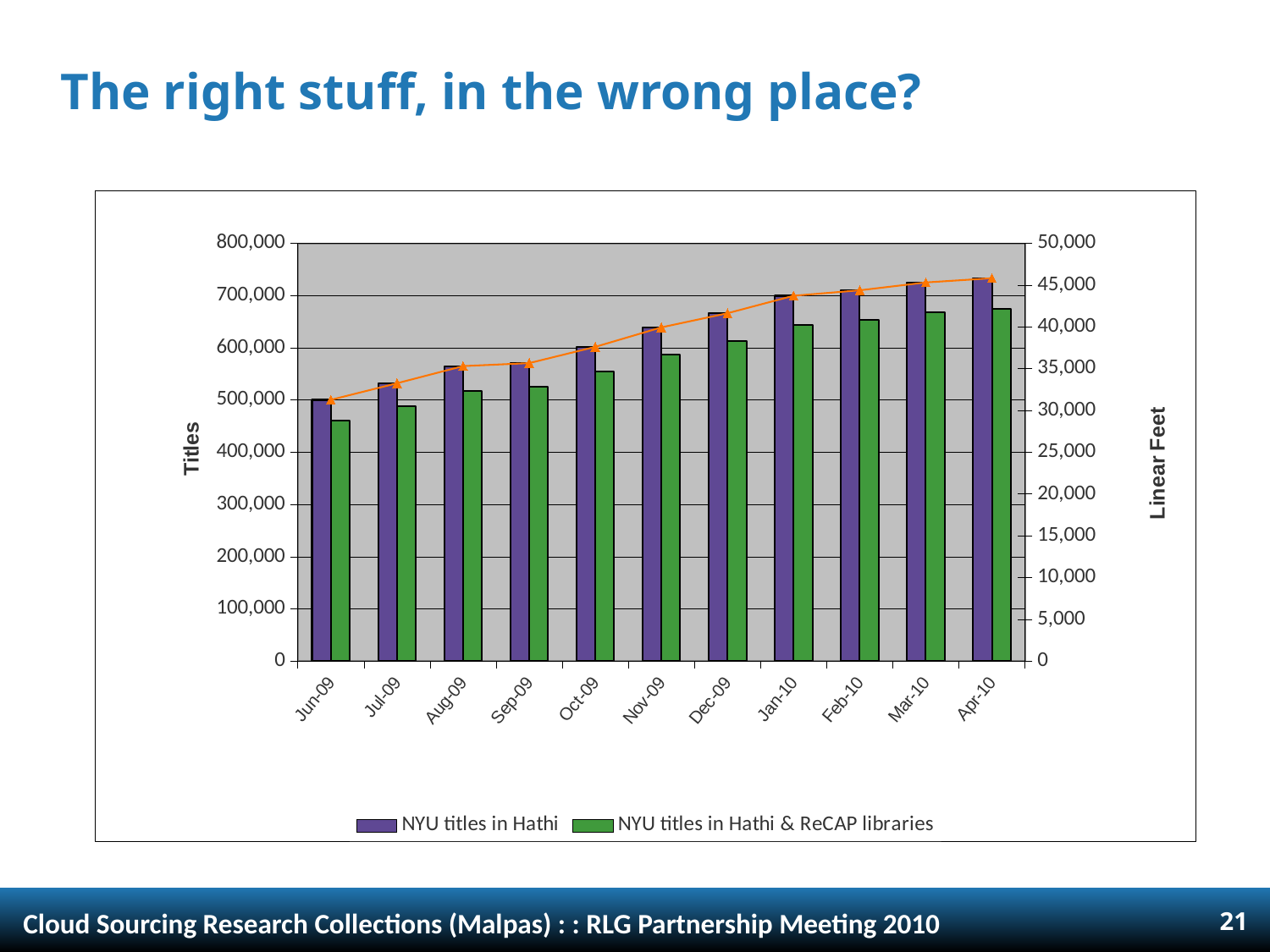
What is the title of the right vertical axis of the chart? Linear Feet In Dec-09, which is larger: NYU titles in Hathi or NYU titles in Hathi & ReCAP libraries? NYU titles in Hathi What kind of chart is shown on the slide? combination bar and line chart How many months are shown along the x axis of the chart? 11 Is the value for NYU titles in Hathi & ReCAP libraries in Jun-09 greater or less than 500,000? less Is the value for NYU titles in Hathi & ReCAP libraries in Mar-10 greater or less than 600,000? greater How many series does the chart's legend list? 2 What is the title of the left vertical axis of the chart? Titles In which month is the value for NYU titles in Hathi highest? Apr-10 In which month is the value for NYU titles in Hathi & ReCAP libraries lowest? Jun-09 Do the values for NYU titles in Hathi rise or fall from Jun-09 to Apr-10? rise Is the value for NYU titles in Hathi in Apr-10 greater or less than 700,000? greater